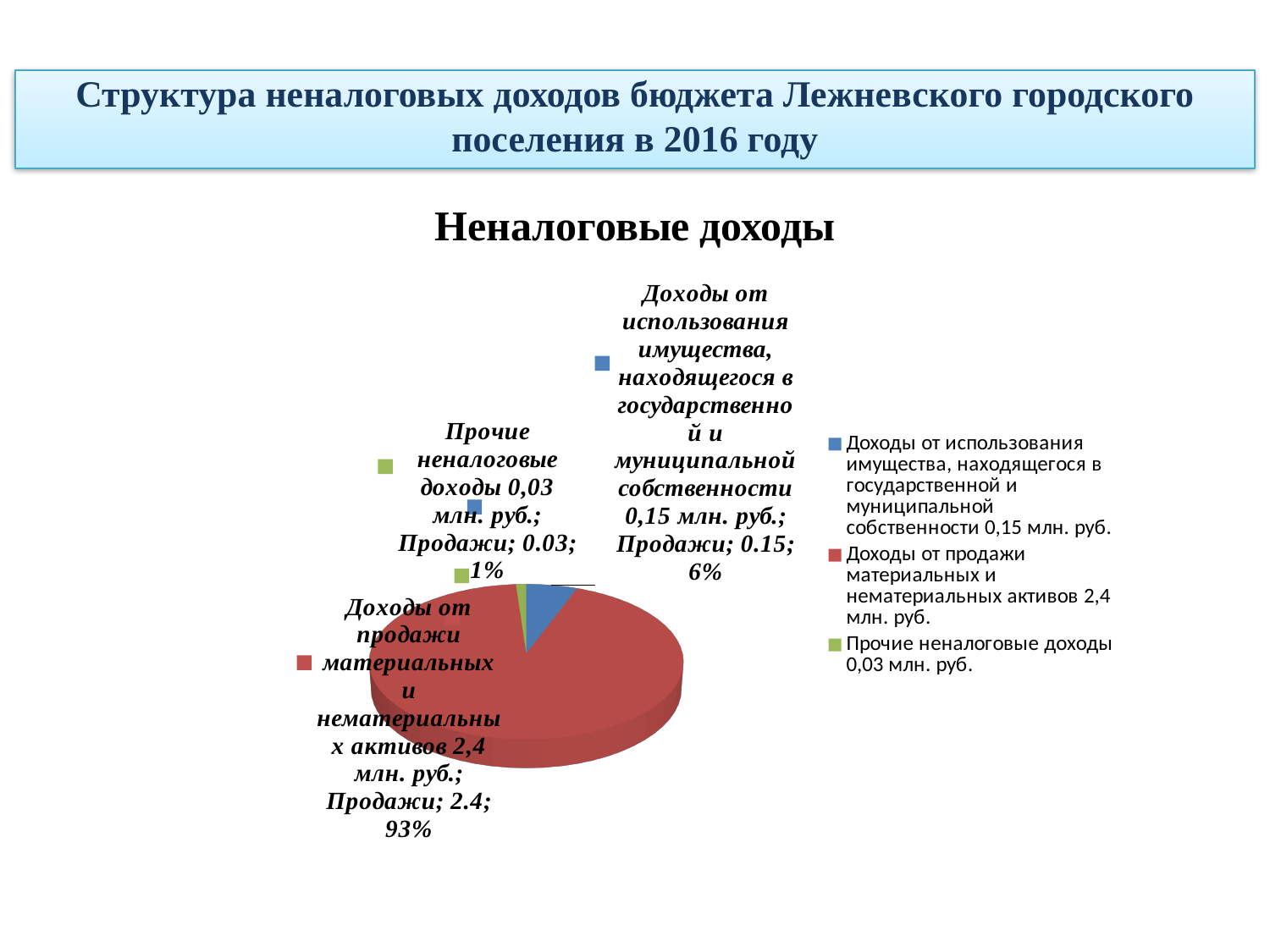
What is the title of the chart? Неналоговые доходы What kind of chart is shown on the slide? pie chart What share of the pie is 'Доходы от использования имущества, находящегося в государственной и муниципальной собственности'? 6% How many entries does the legend list? 3 How many slices does the pie chart have? 3 What share of the pie is 'Доходы от продажи материальных и нематериальных активов'? 93% What share of the pie is 'Прочие неналоговые доходы'? 1% What is the value shown for 'Прочие неналоговые доходы'? 0,03 млн. руб. Which is larger: 'Доходы от использования имущества' or 'Прочие неналоговые доходы'? Доходы от использования имущества Which category has the smallest slice of the pie? Прочие неналоговые доходы What is the value shown for 'Доходы от использования имущества, находящегося в государственной и муниципальной собственности'? 0,15 млн. руб. Which category has the largest slice of the pie? Доходы от продажи материальных и нематериальных активов